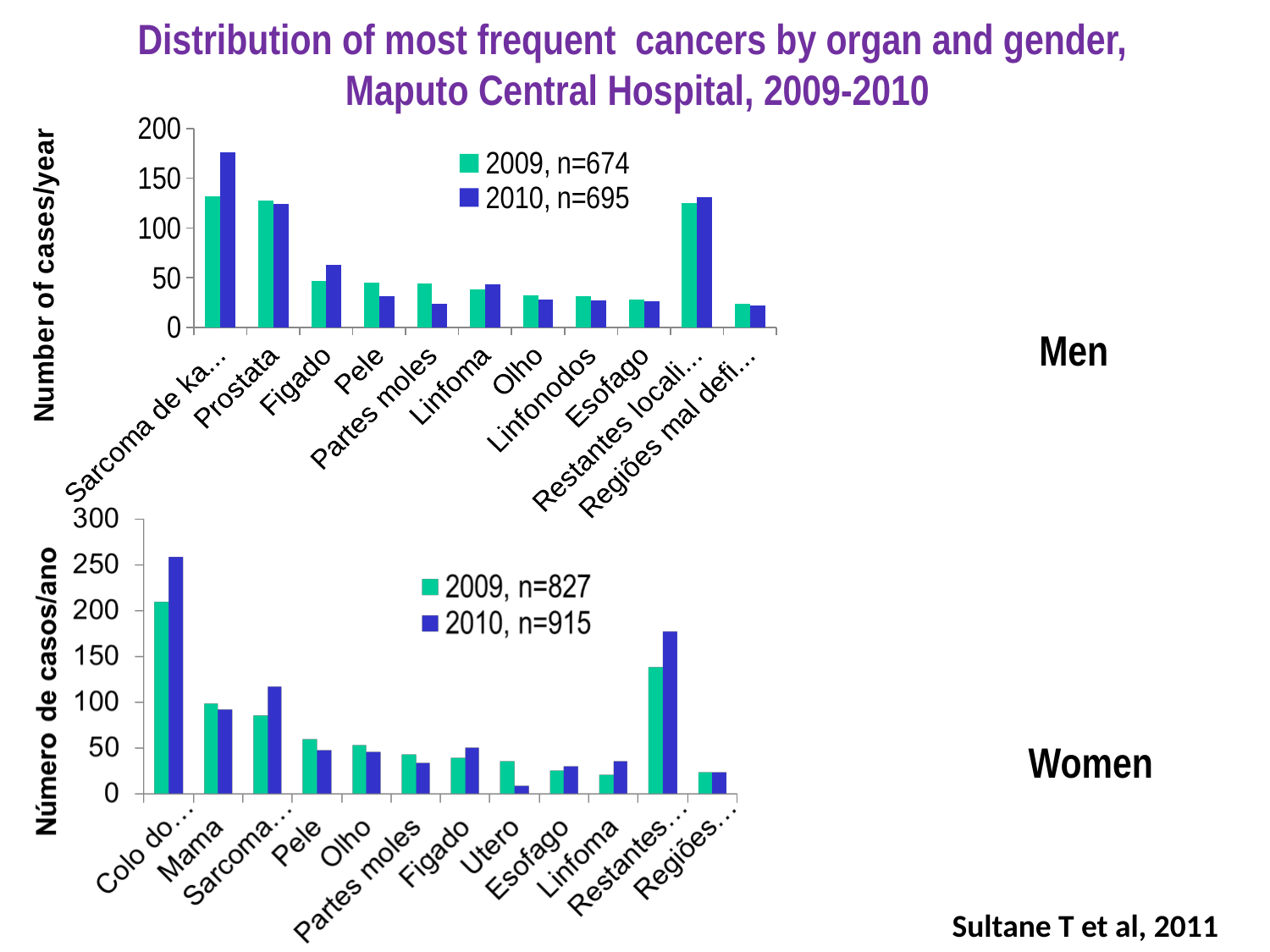
In the Men chart (top), is the value for Figado in 2010, n=695 greater or less than 50? greater In the Women chart (bottom), which category has the tallest bar for 2010, n=915? Colo do... In the Women chart (bottom), is the value for Restantes... in 2010, n=915 greater or less than 150? greater In the Women chart (bottom), which is larger for Sarcoma...: the 2009, n=827 value or the 2010, n=915 value? 2010, n=915 In the Men chart (top), is the value for Prostata in 2009, n=674 greater or less than 100? greater In the Men chart (top), which is larger for Figado: the 2009, n=674 value or the 2010, n=695 value? 2010, n=695 In the Men chart (top), which category has the tallest bar for 2010, n=695? Sarcoma de ka... How many series does the legend of the Men chart (top) list? 2 How many categories are shown on the x axis of the Women chart (bottom)? 12 What type of chart is the Men chart (top)? Bar chart In the Women chart (bottom), which category has the shortest bar for 2010, n=915? Utero